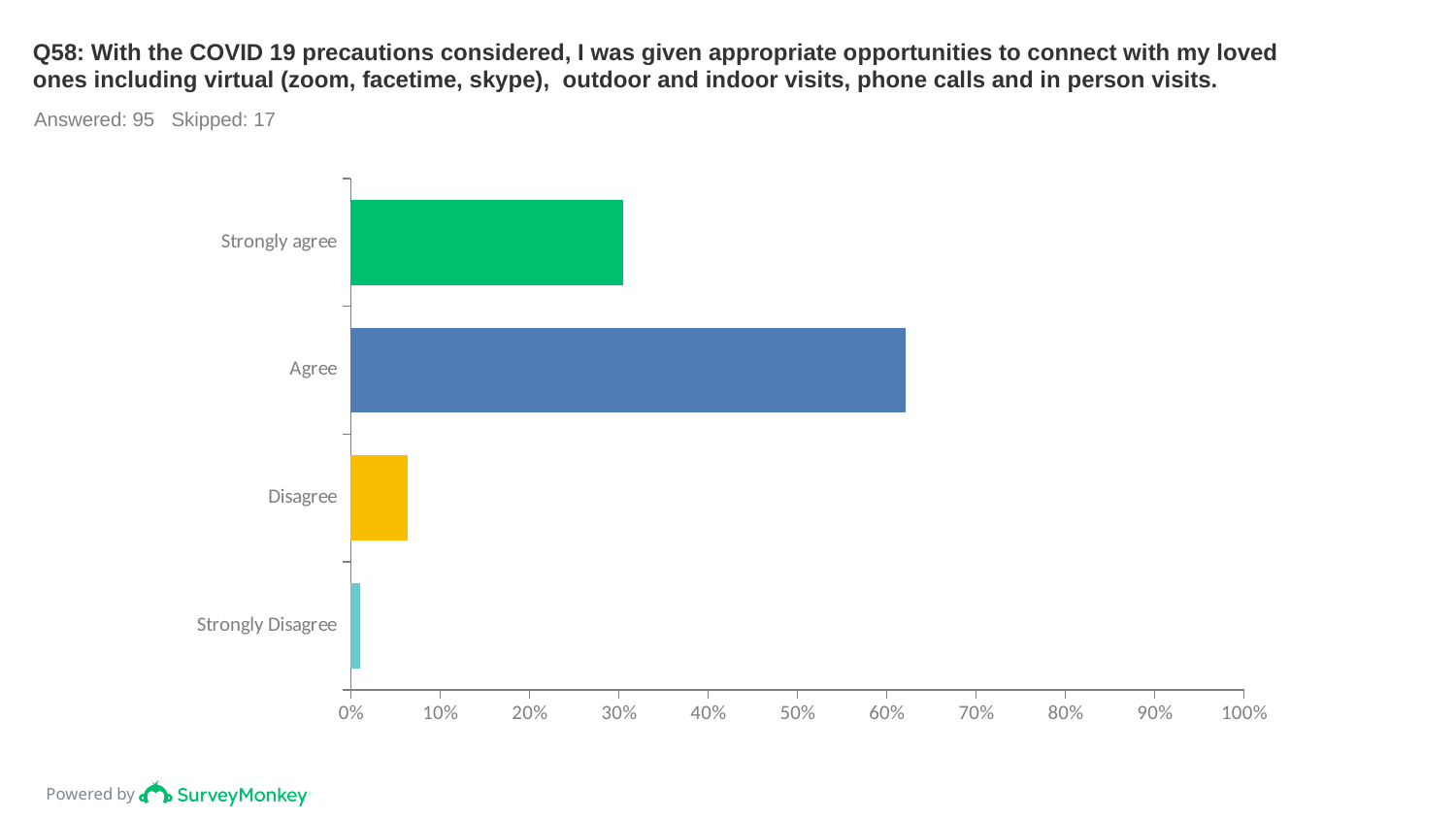
Which response category has the highest value? Agree What kind of chart is shown on the slide? bar chart Which response category has the lowest value? Strongly Disagree How many respondents answered this question according to the slide? 95 What colour is the bar for Agree? blue Is the value for Strongly agree greater or less than 40%? less Which is larger, the value for Disagree or the value for Strongly Disagree? Disagree How many response categories are shown in the chart? 4 Is the value for Agree greater or less than 60%? greater Is the value for Strongly Disagree greater or less than 10%? less Which is larger, the value for Strongly agree or the value for Agree? Agree